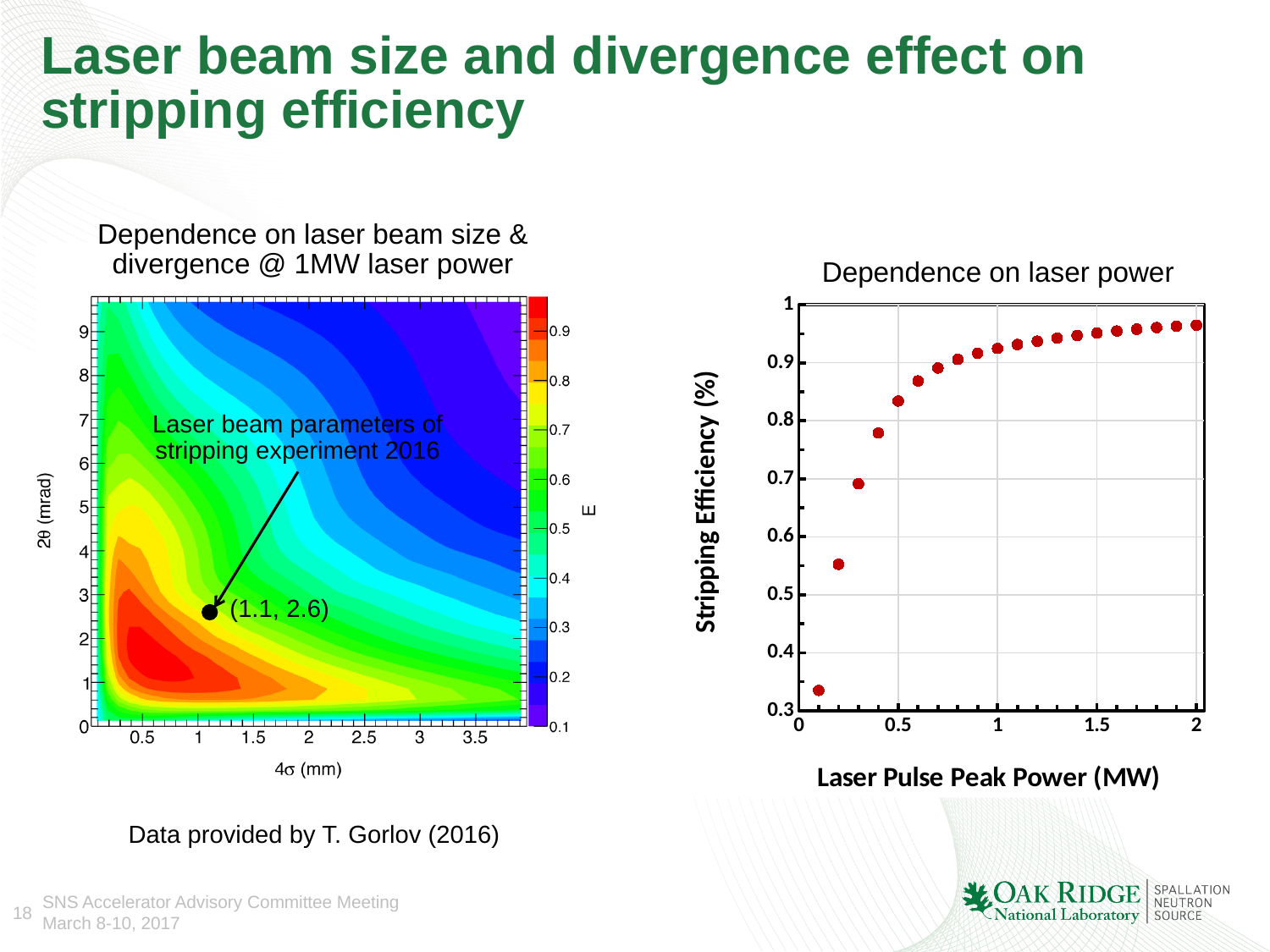
In the 'Dependence on laser power' chart, do the stripping efficiency values rise or fall as laser pulse peak power increases? rise In the 'Dependence on laser power' chart, at which laser pulse peak power is the stripping efficiency highest? 2 MW What kind of chart is the 'Dependence on laser power' chart on the right? scatter plot In the left contour chart, what are the coordinates of the marked point labelled as the laser beam parameters of the 2016 stripping experiment? (1.1, 2.6) In the 'Dependence on laser power' chart, is the stripping efficiency at 2 MW greater or less than 0.9? greater In the 'Dependence on laser power' chart, is the stripping efficiency at 0.1 MW greater or less than 0.4? less How many data points are plotted in the 'Dependence on laser power' chart? 20 What is the x-axis label of the 'Dependence on laser power' chart? Laser Pulse Peak Power (MW) In the 'Dependence on laser power' chart, is the stripping efficiency at 0.5 MW greater or less than 0.8? greater What kind of chart is the 'Dependence on laser beam size & divergence @ 1MW laser power' chart on the left? contour plot In the 'Dependence on laser power' chart, at which laser pulse peak power is the stripping efficiency lowest? 0.1 MW In the 'Dependence on laser power' chart, is the stripping efficiency at 1 MW larger or smaller than at 0.5 MW? larger